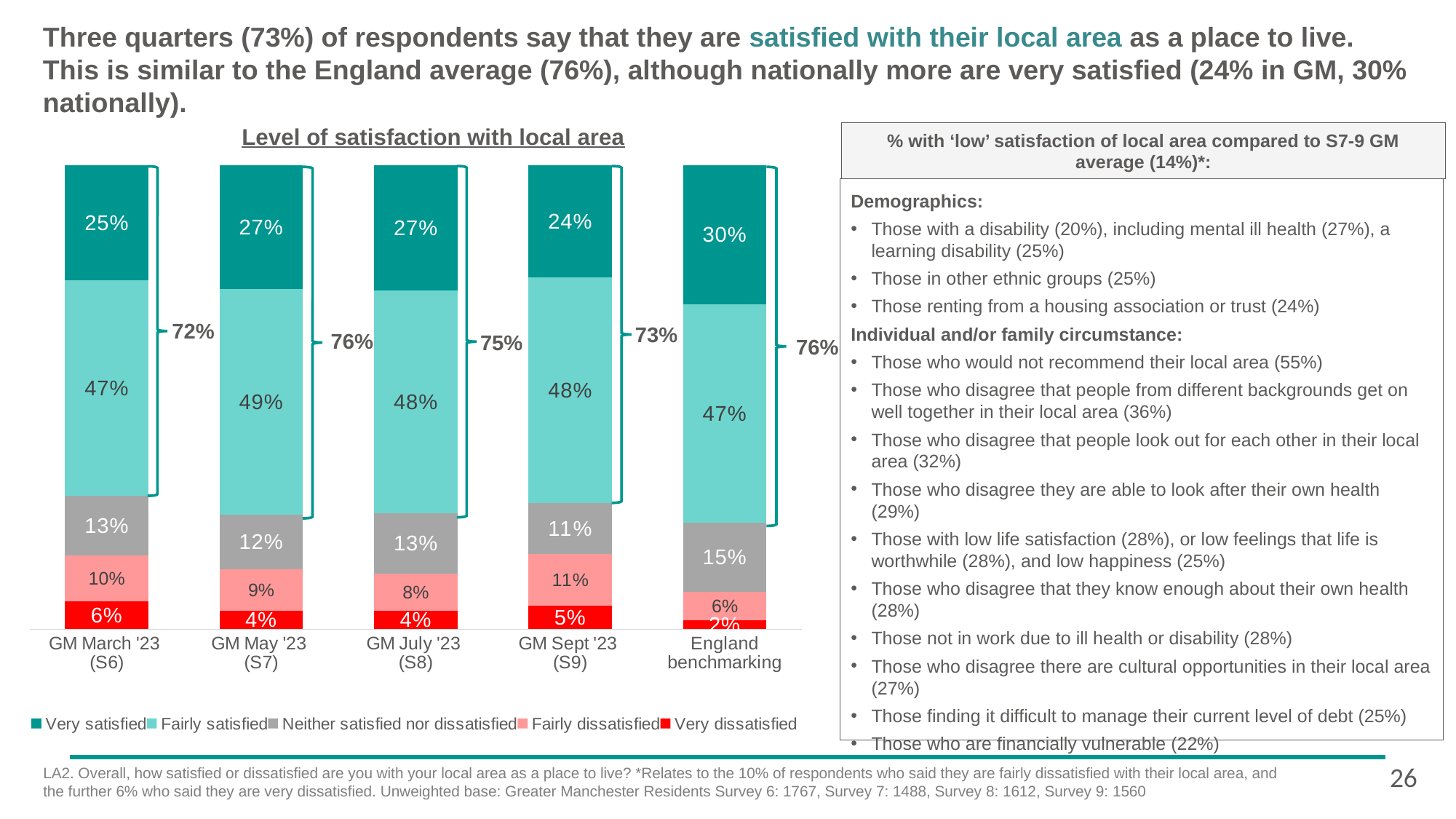
What kind of chart is shown on the slide? Stacked bar chart What percentage were very dissatisfied in GM March '23 (S6)? 6% What is the Neither satisfied nor dissatisfied value for GM July '23 (S8)? 13% What is the difference between the Very satisfied value for England benchmarking and for GM Sept '23 (S9)? 6 percentage points What percentage of respondents were very satisfied in GM Sept '23 (S9)? 24% How many series does the chart legend list? 5 Which category has the lowest Very dissatisfied value? England benchmarking What combined satisfied percentage is shown by the bracket for GM May '23 (S7)? 76% Which category has the highest Very satisfied value? England benchmarking What is the Fairly satisfied value for England benchmarking? 47% Which has a higher Fairly satisfied value, GM May '23 (S7) or GM July '23 (S8)? GM May '23 (S7) How many categories are shown on the x axis of the chart? 5